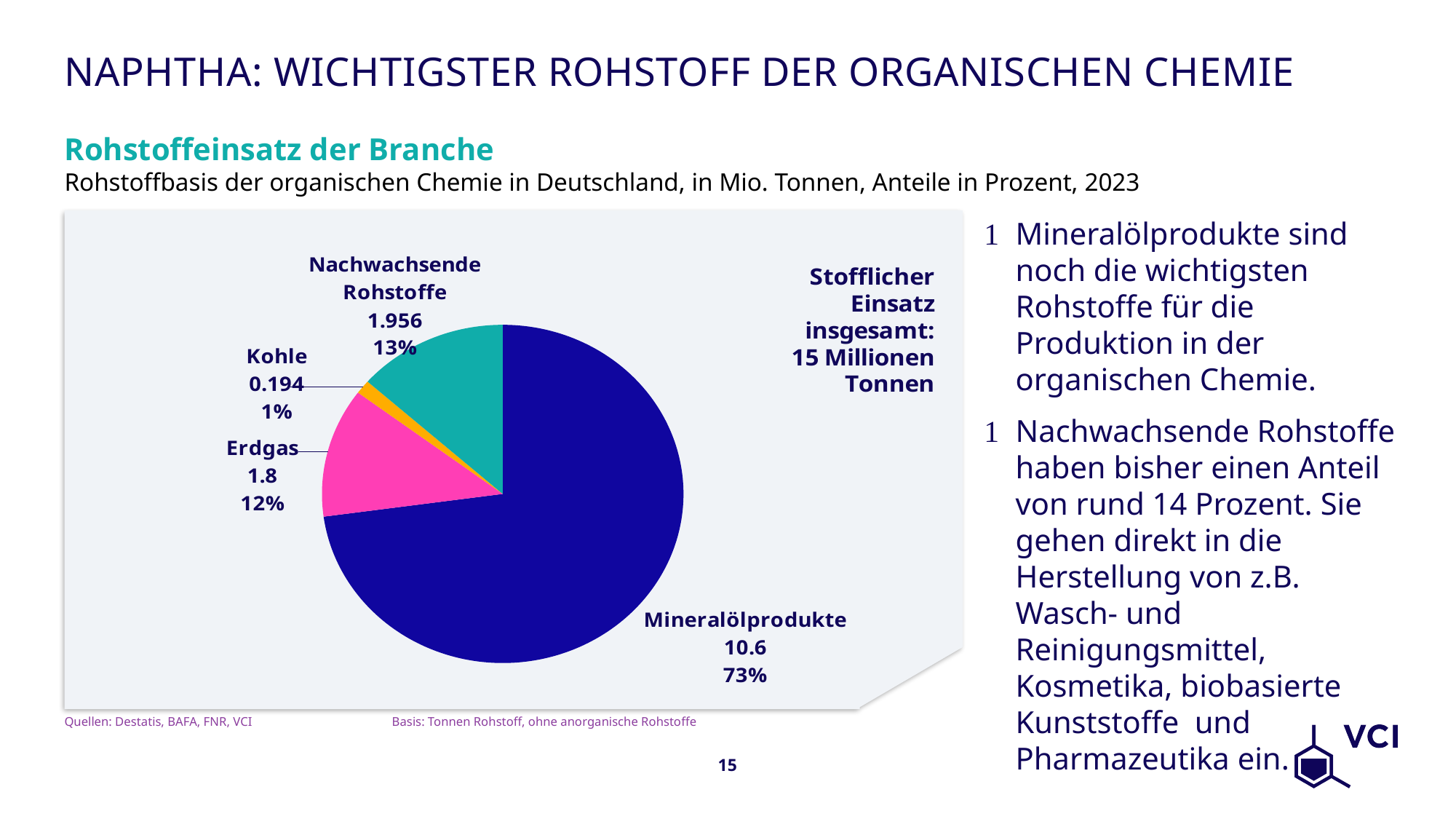
Which category has the smallest slice of the pie? Kohle Which category has the largest slice of the pie? Mineralölprodukte What is the value for Kohle? 0.194 Which is larger, the slice for Nachwachsende Rohstoffe or the slice for Erdgas? Nachwachsende Rohstoffe How many slices does the pie chart have? 4 What percentage share does Erdgas have in the pie chart? 12% What is the difference between the values for Erdgas and Kohle? 1.606 What kind of chart is shown on the slide? pie chart What is the value for Nachwachsende Rohstoffe? 1.956 What is the value for Mineralölprodukte in the pie chart? 10.6 What is the title of the chart? Rohstoffeinsatz der Branche What percentage share does Mineralölprodukte have? 73%